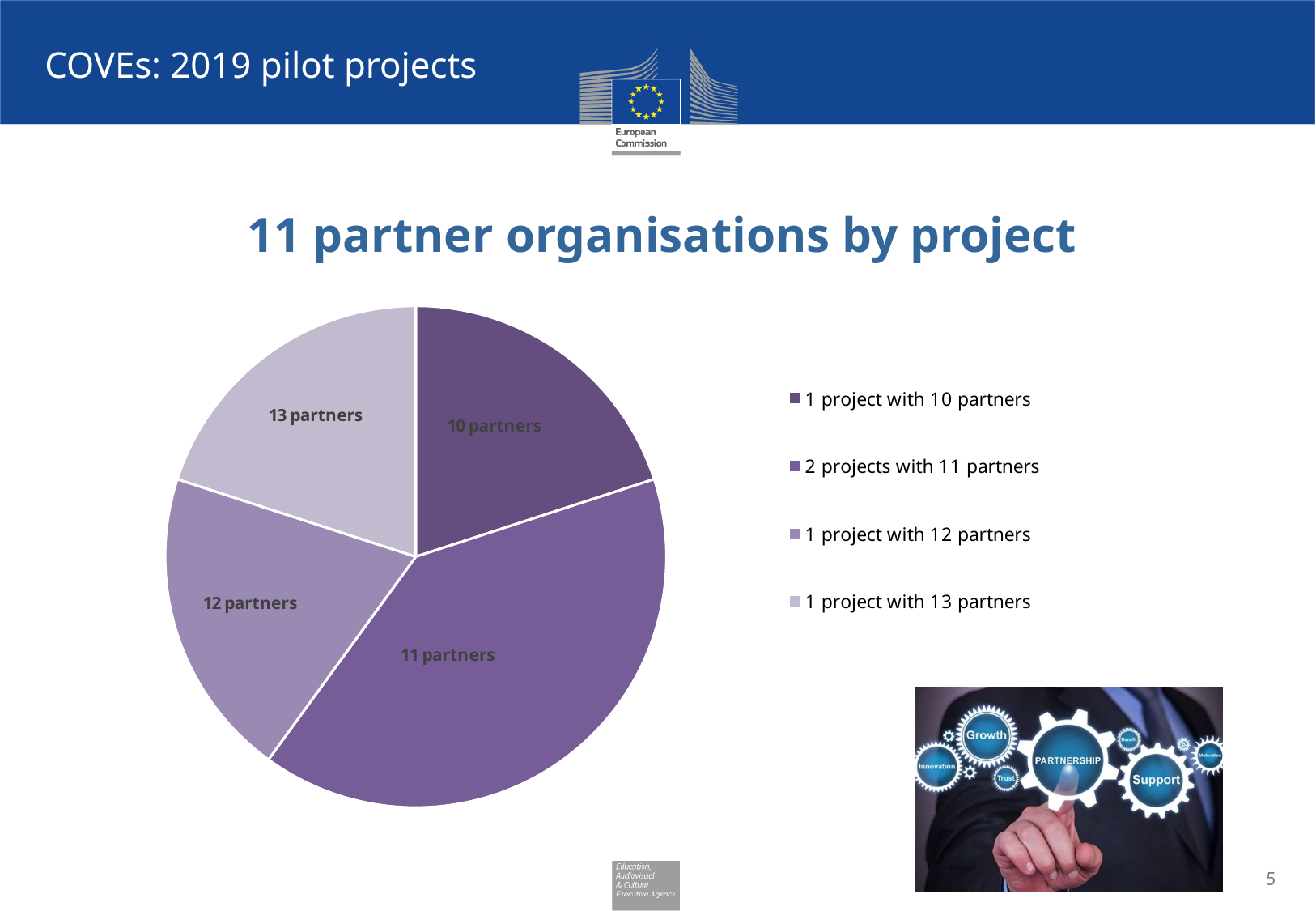
What kind of chart is shown on the slide? pie chart According to the legend, how many projects have 11 partners? 2 According to the legend, how many projects have 13 partners? 1 How many slices does the pie chart have? 4 Which slice of the pie chart is the lightest in colour? 13 partners According to the legend, how many projects have 10 partners? 1 Which slice of the pie chart is the largest? 11 partners What is the title of the chart on the slide? 11 partner organisations by project Which slice is larger, 11 partners or 12 partners? 11 partners What is the total number of projects represented in the pie chart, according to the legend? 5 What share of the projects in the pie chart have 11 partners? 40% How many entries does the chart legend list? 4